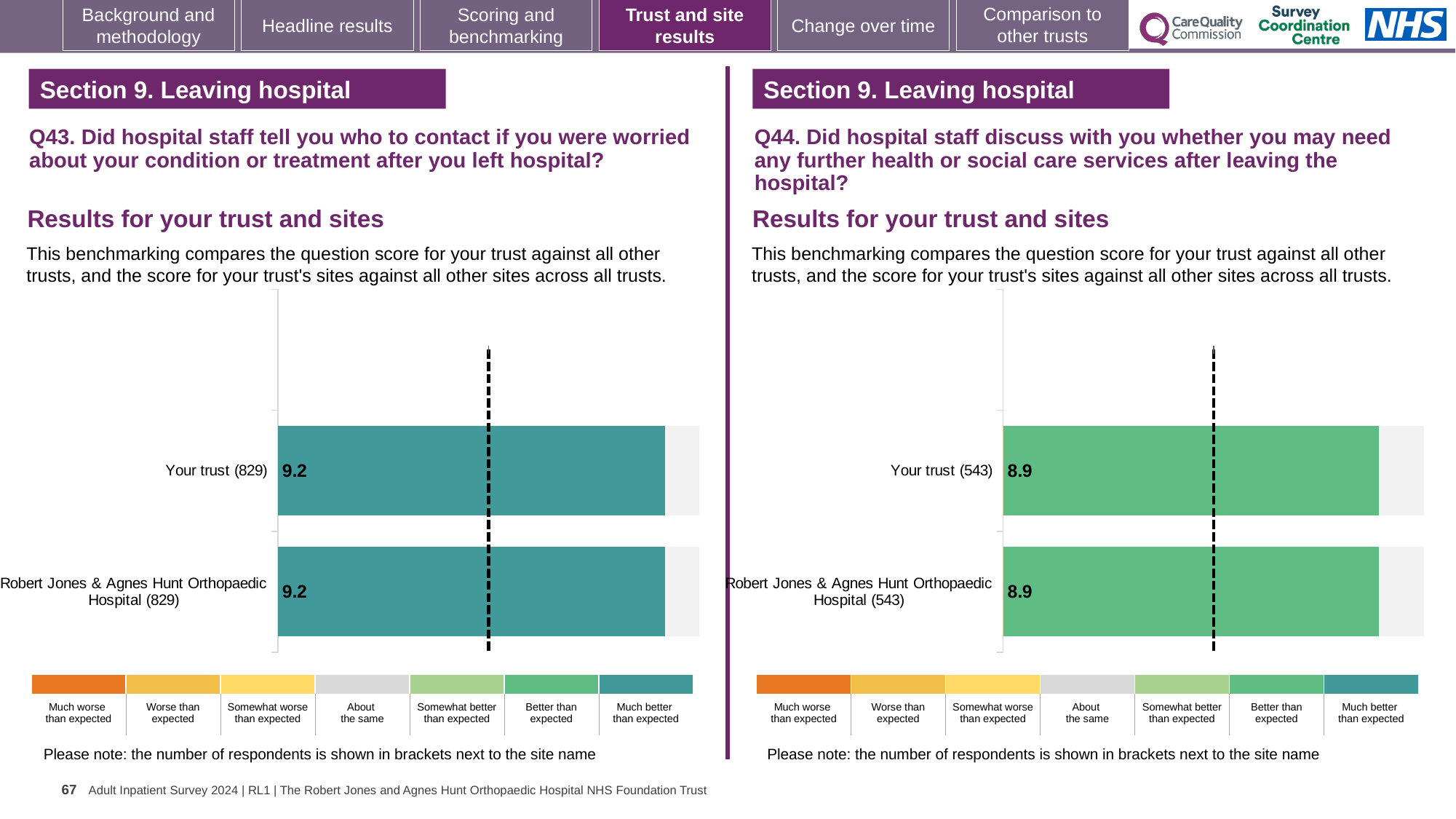
On the left chart (Q43), which benchmark category does the colour of the bars correspond to in the legend? Much better than expected What kind of chart is used on the left (Q43)? Bar chart On the right chart (Q44), how many respondents are shown in brackets for Robert Jones & Agnes Hunt Orthopaedic Hospital? 543 On the right chart (Q44), what is the score for Robert Jones & Agnes Hunt Orthopaedic Hospital? 8.9 On the left chart (Q43), how many respondents are shown in brackets for Your trust? 829 Which is larger: the Your trust score on the left chart (Q43) or the Your trust score on the right chart (Q44)? Left chart (Q43), 9.2 On the right chart (Q44), what is the score for Your trust? 8.9 On the left chart (Q43), what is the score for Robert Jones & Agnes Hunt Orthopaedic Hospital? 9.2 On the left chart (Q43), what is the difference between the score for Your trust and the score for Robert Jones & Agnes Hunt Orthopaedic Hospital? 0 How many bars are plotted on the right chart (Q44)? 2 On the right chart (Q44), which benchmark category does the colour of the bars correspond to in the legend? Better than expected On the left chart (Q43), what is the score for Your trust? 9.2